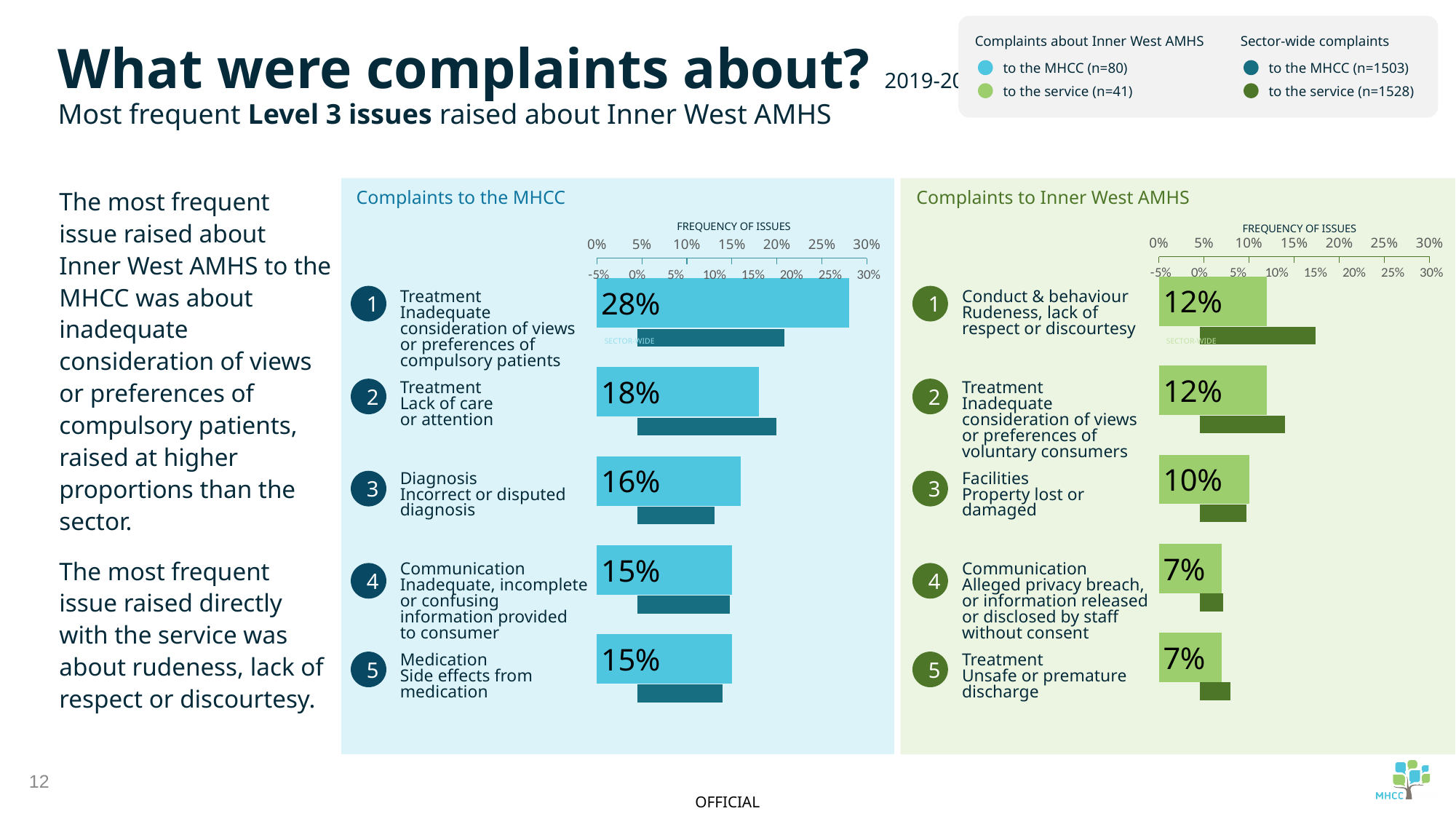
According to the legend, how many complaints about Inner West AMHS were made to the MHCC? n=80 How many issues are listed in the 'Complaints to Inner West AMHS' chart? 5 In the 'Complaints to Inner West AMHS' chart, what is the frequency for Facilities – Property lost or damaged? 10% In the 'Complaints to the MHCC' chart, what is the frequency for Diagnosis – Incorrect or disputed diagnosis? 16% In the 'Complaints to the MHCC' chart, which is larger: the frequency for Diagnosis or for Communication? Diagnosis In the 'Complaints to Inner West AMHS' chart, what is the difference between the Conduct & behaviour frequency and the Communication frequency? 5 percentage points In the 'Complaints to the MHCC' chart, what is the frequency for Treatment – Inadequate consideration of views or preferences of compulsory patients? 28% In the 'Complaints to the MHCC' chart, is the sector-wide bar for Diagnosis greater or less than 20%? less In the 'Complaints to the MHCC' chart, which issue has the highest frequency? Treatment – Inadequate consideration of views or preferences of compulsory patients In the 'Complaints to Inner West AMHS' chart, what is the frequency for Treatment – Unsafe or premature discharge? 7% What type of chart is used to show the frequency of issues in the 'Complaints to the MHCC' panel? Bar chart In the 'Complaints to the MHCC' chart, what is the difference in frequency between the Treatment – Inadequate consideration issue (28%) and Treatment – Lack of care or attention (18%)? 10 percentage points